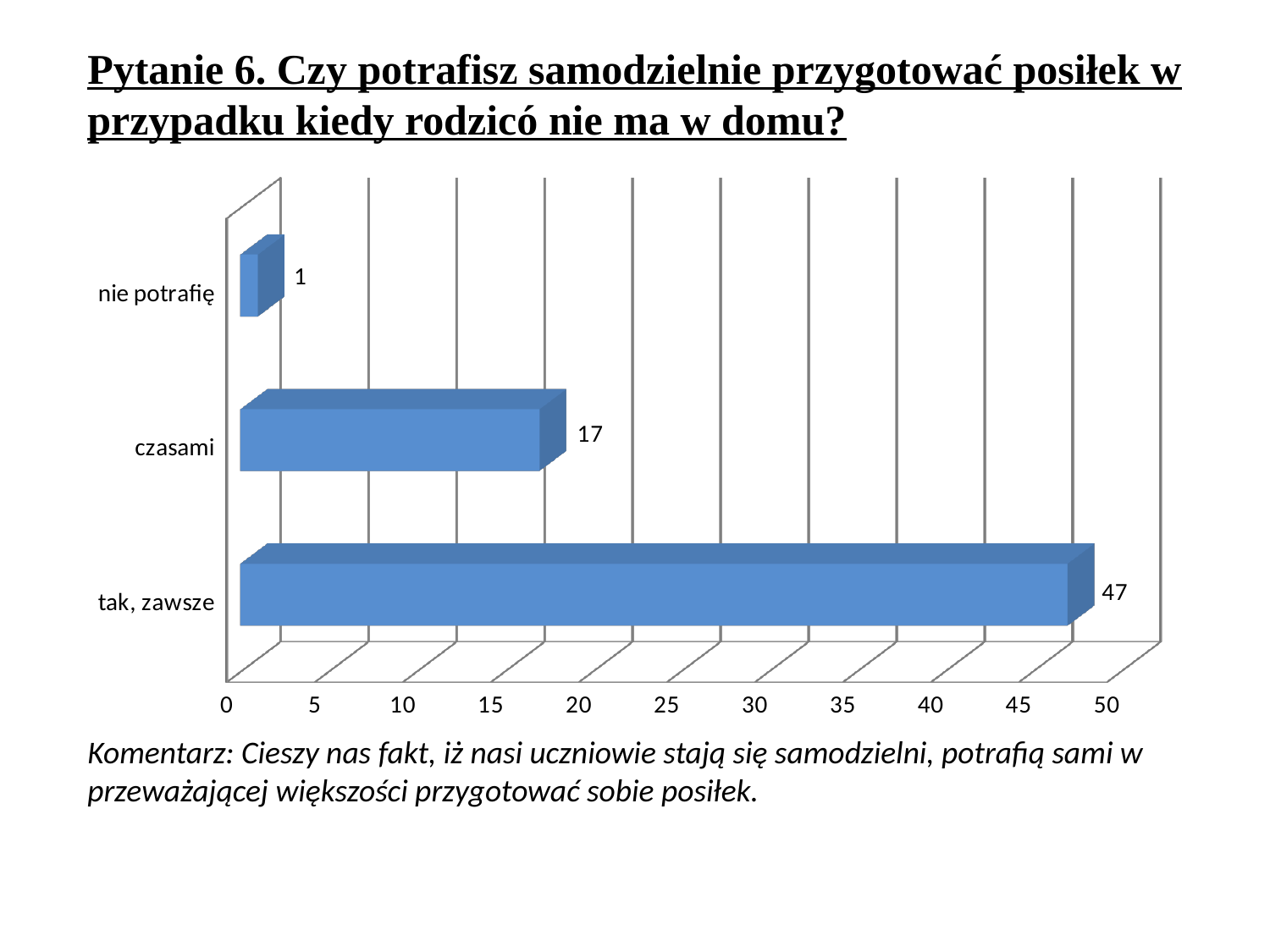
Which category has the highest value? tak, zawsze What is the highest value shown on the horizontal axis? 50 What is the value for "nie potrafię"? 1 Which is larger, the value for "czasami" or the value for "nie potrafię"? czasami Is the value for "tak, zawsze" greater or less than 40? greater What kind of chart is shown on the slide? bar chart What is the value for "czasami"? 17 What is the value for "tak, zawsze"? 47 What is the difference between the values for "tak, zawsze" and "czasami"? 30 Which category has the lowest value? nie potrafię What is the difference between the values for "czasami" and "nie potrafię"? 16 How many categories are shown in the chart? 3